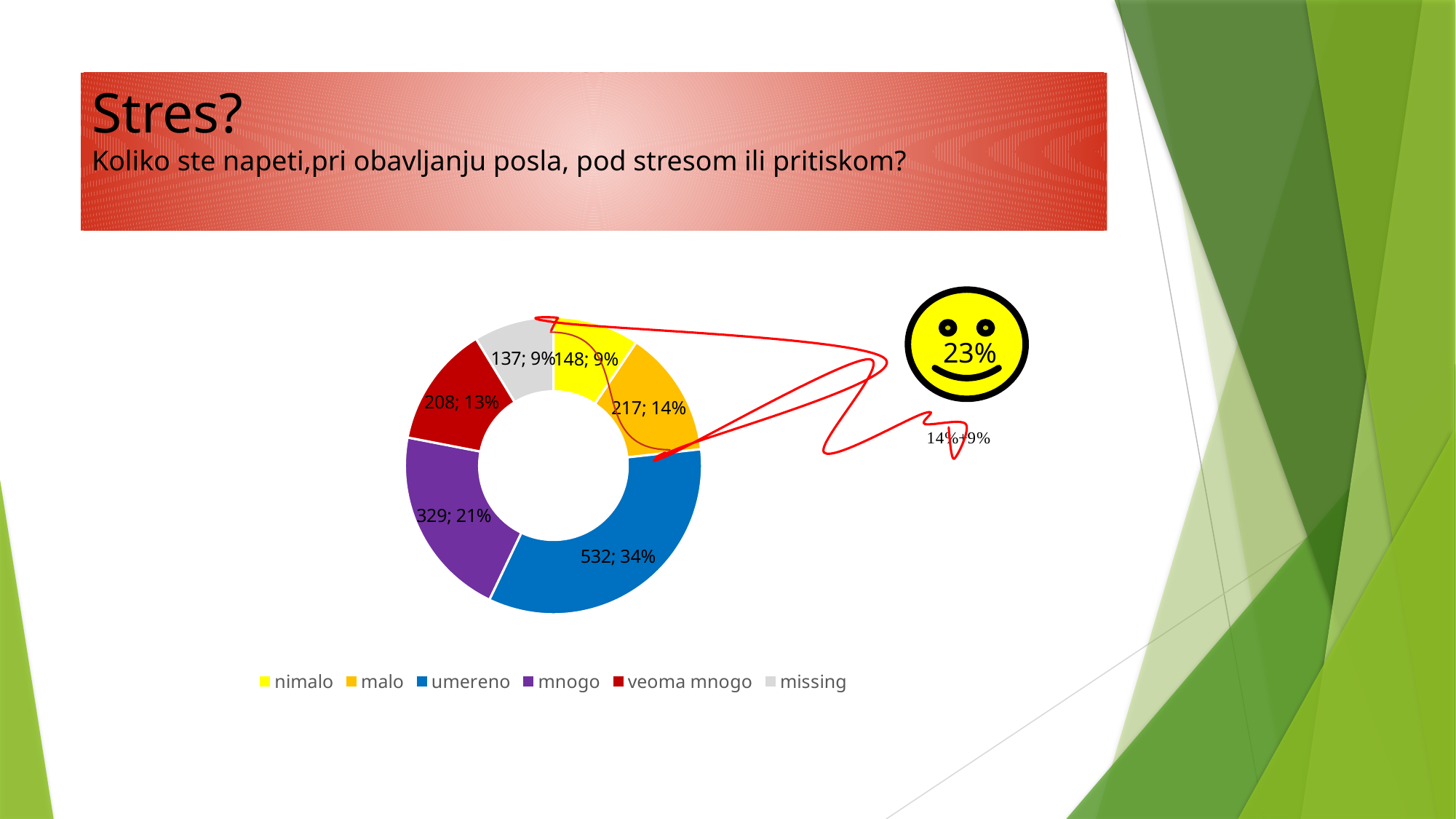
What percentage share does the 'mnogo' slice have? 21% Which has a larger count, 'malo' or 'veoma mnogo'? malo What is the count for the 'veoma mnogo' category? 208 What colour represents the 'mnogo' category in the chart? purple What is the count for the 'nimalo' category? 148 How many categories does the legend of the chart list? 6 Which category has the largest slice? umereno What kind of chart is shown on the slide? doughnut chart What is the difference between the counts for 'umereno' and 'mnogo'? 203 Which category has the smallest count? missing What percentage share does the 'malo' slice have? 14% What is the count for the 'umereno' category? 532